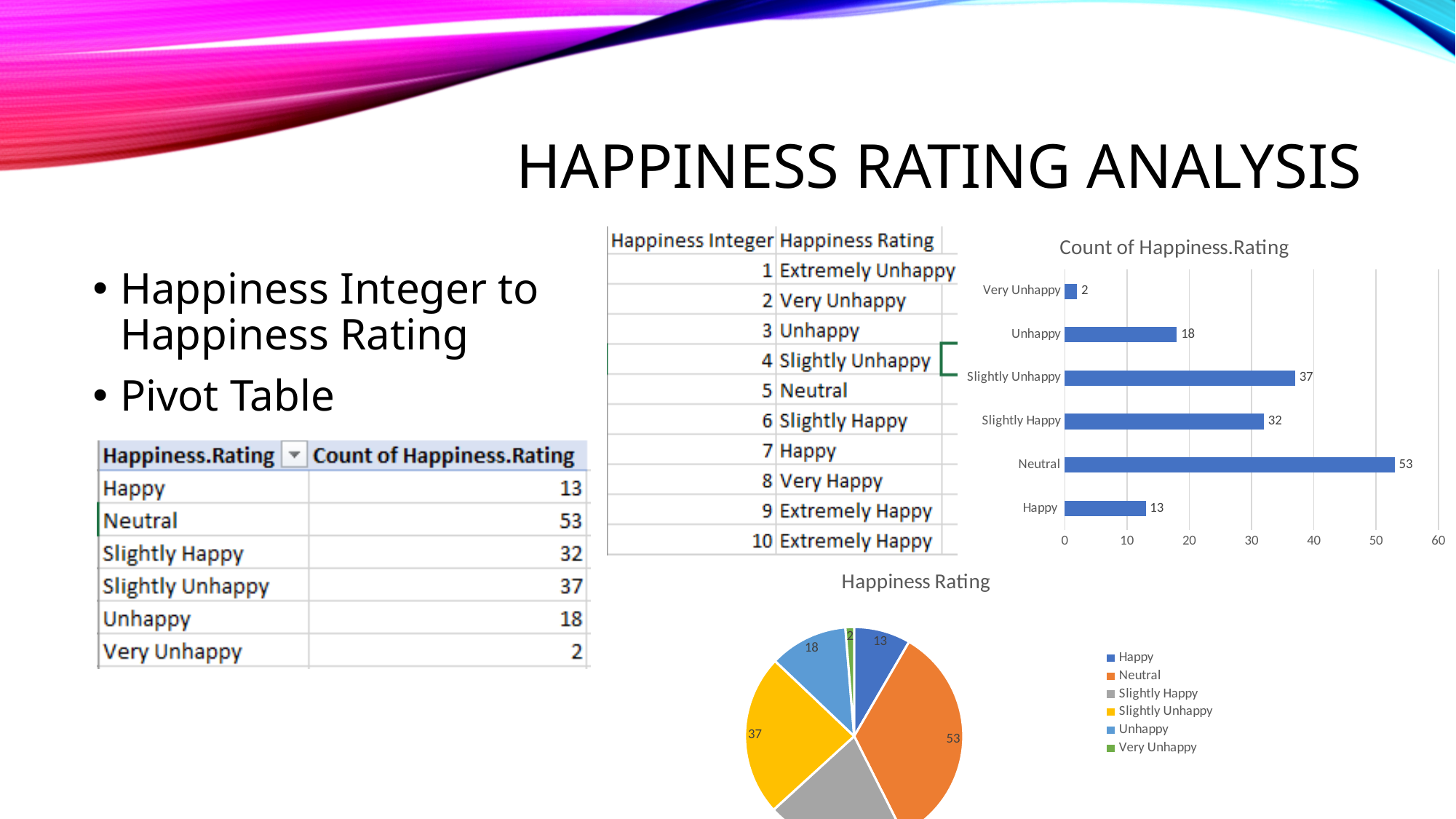
What kind of chart is the 'Count of Happiness.Rating' chart? Bar chart How many entries does the legend of the 'Happiness Rating' pie chart list? 6 In the 'Count of Happiness.Rating' bar chart, what is the difference between the Neutral and Happy counts? 40 In the 'Count of Happiness.Rating' bar chart, what is the value for Neutral? 53 In the 'Count of Happiness.Rating' bar chart, which is larger, Slightly Unhappy or Slightly Happy? Slightly Unhappy How many categories are shown in the 'Count of Happiness.Rating' bar chart? 6 In the 'Count of Happiness.Rating' bar chart, which category has the highest count? Neutral In the 'Count of Happiness.Rating' bar chart, which category has the lowest count? Very Unhappy In the 'Count of Happiness.Rating' bar chart, is the value for Unhappy greater or less than 20? less In the 'Count of Happiness.Rating' bar chart, what is the value for Slightly Unhappy? 37 In the 'Count of Happiness.Rating' bar chart, what is the value for Very Unhappy? 2 In the 'Happiness Rating' pie chart, what colour is the Neutral slice? Orange